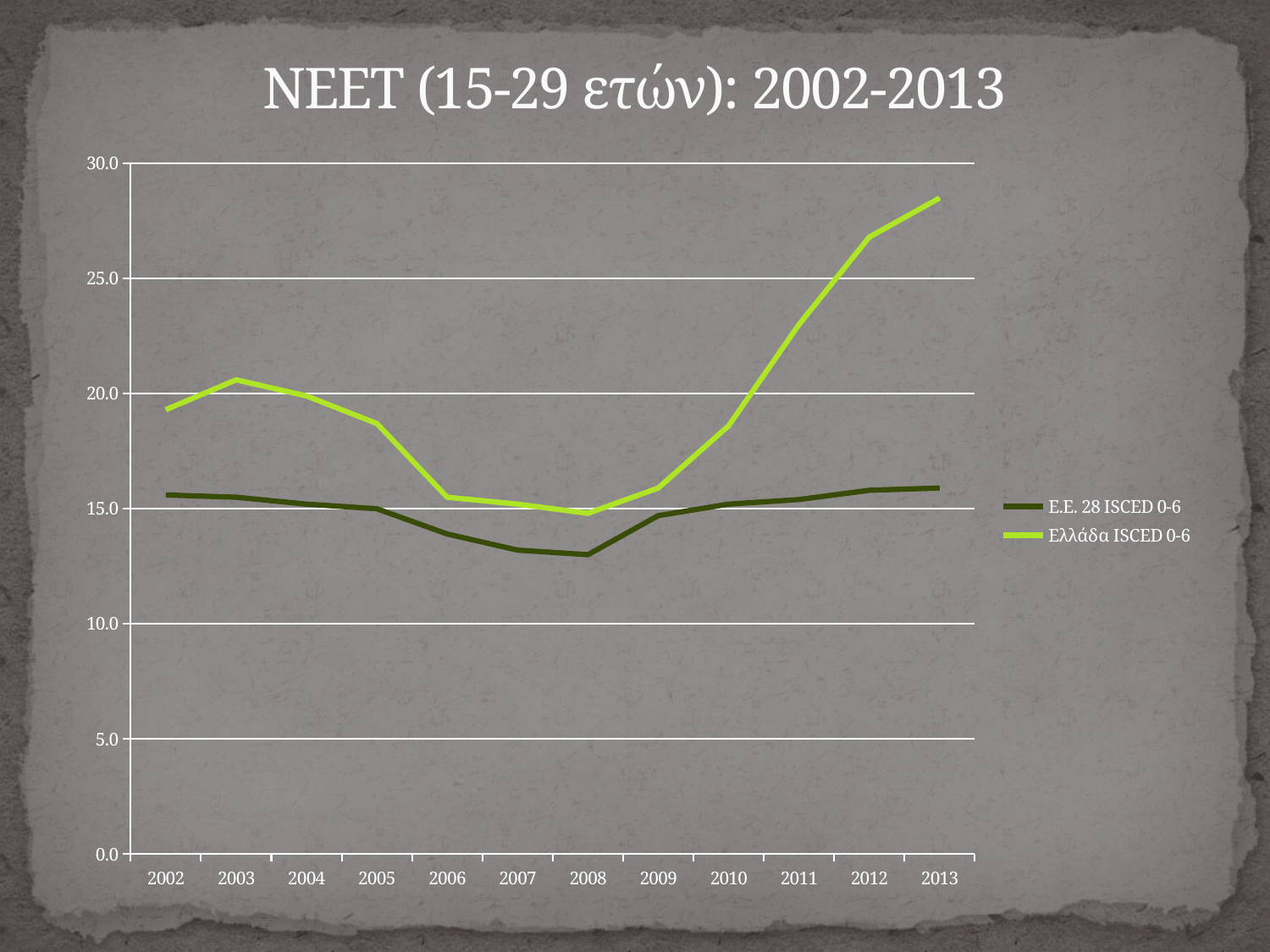
In 2013, which series has the larger value, Ε.Ε. 28 ISCED 0-6 or Ελλάδα ISCED 0-6? Ελλάδα ISCED 0-6 Is the value for Ελλάδα ISCED 0-6 in 2002 greater or less than 20.0? less Is the value for Ελλάδα ISCED 0-6 in 2013 greater or less than 25.0? greater In which year does the Ελλάδα ISCED 0-6 line reach its lowest value? 2008 How many series does the legend list? 2 What kind of chart is shown on the slide? line chart In which year does the Ελλάδα ISCED 0-6 line reach its highest value? 2013 How many years are shown on the x axis? 12 In which year does the Ε.Ε. 28 ISCED 0-6 line reach its lowest value? 2008 Does the Ελλάδα ISCED 0-6 line rise or fall between 2008 and 2013? rise Is the value for Ε.Ε. 28 ISCED 0-6 in 2008 greater or less than 15.0? less What is the title of the chart? NEET (15-29 ετών): 2002-2013